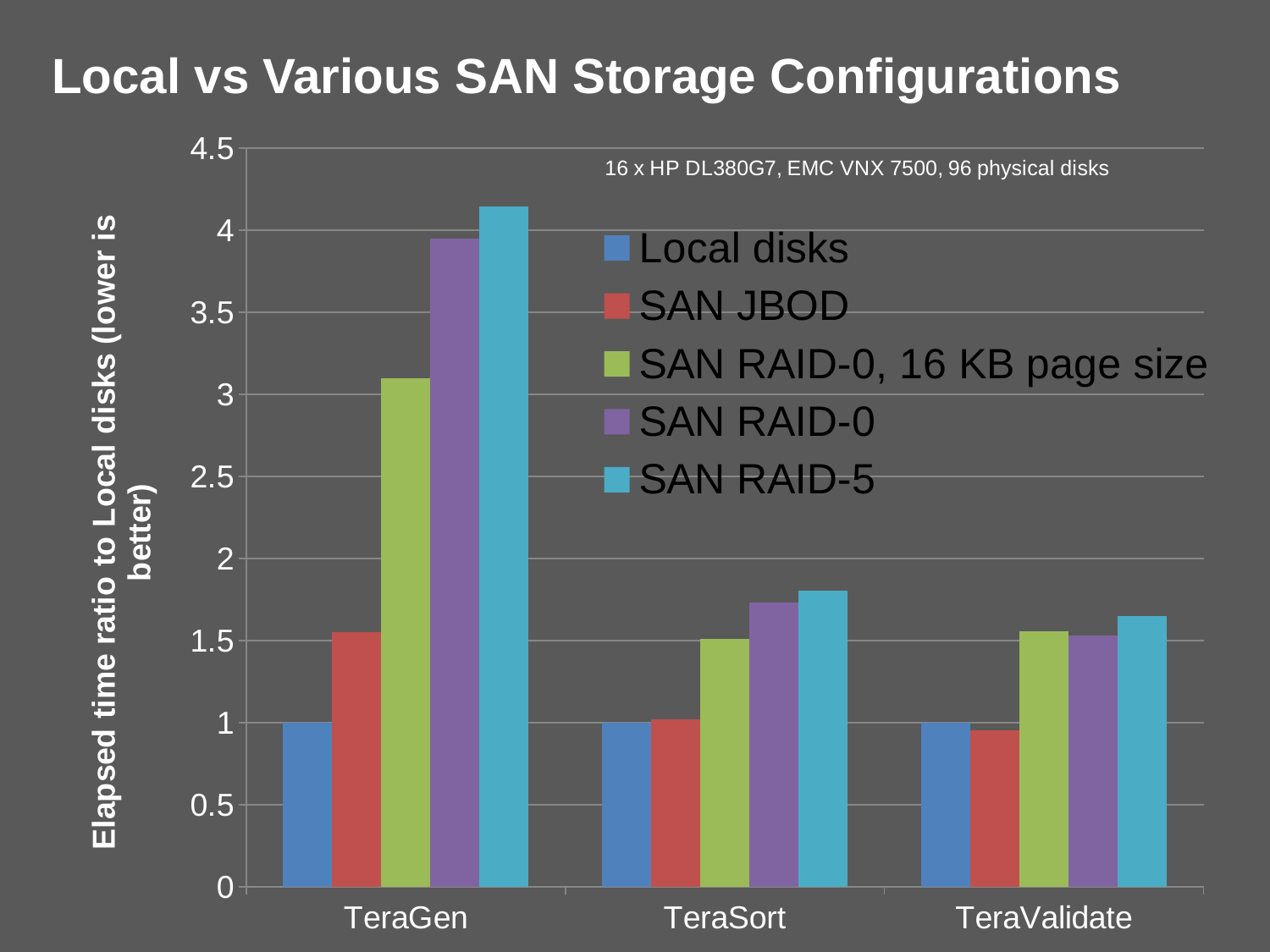
What is the title of the y axis? Elapsed time ratio to Local disks (lower is better) How many series does the legend list? 5 Which is larger: the SAN RAID-5 value for TeraGen or the SAN RAID-5 value for TeraSort? TeraGen What kind of chart is shown on the slide? bar chart Is the value for SAN RAID-0 in the TeraGen category greater or less than 3.5? greater Which is larger in the TeraGen category: SAN RAID-0, 16 KB page size or SAN JBOD? SAN RAID-0, 16 KB page size What is the elapsed time ratio for Local disks in the TeraGen category? 1 Is the value for SAN RAID-5 in the TeraValidate category greater or less than 1.5? greater How many categories are shown on the x axis? 3 Is the value for SAN JBOD in the TeraGen category greater or less than 2? less Which series has the highest value in the TeraGen category? SAN RAID-5